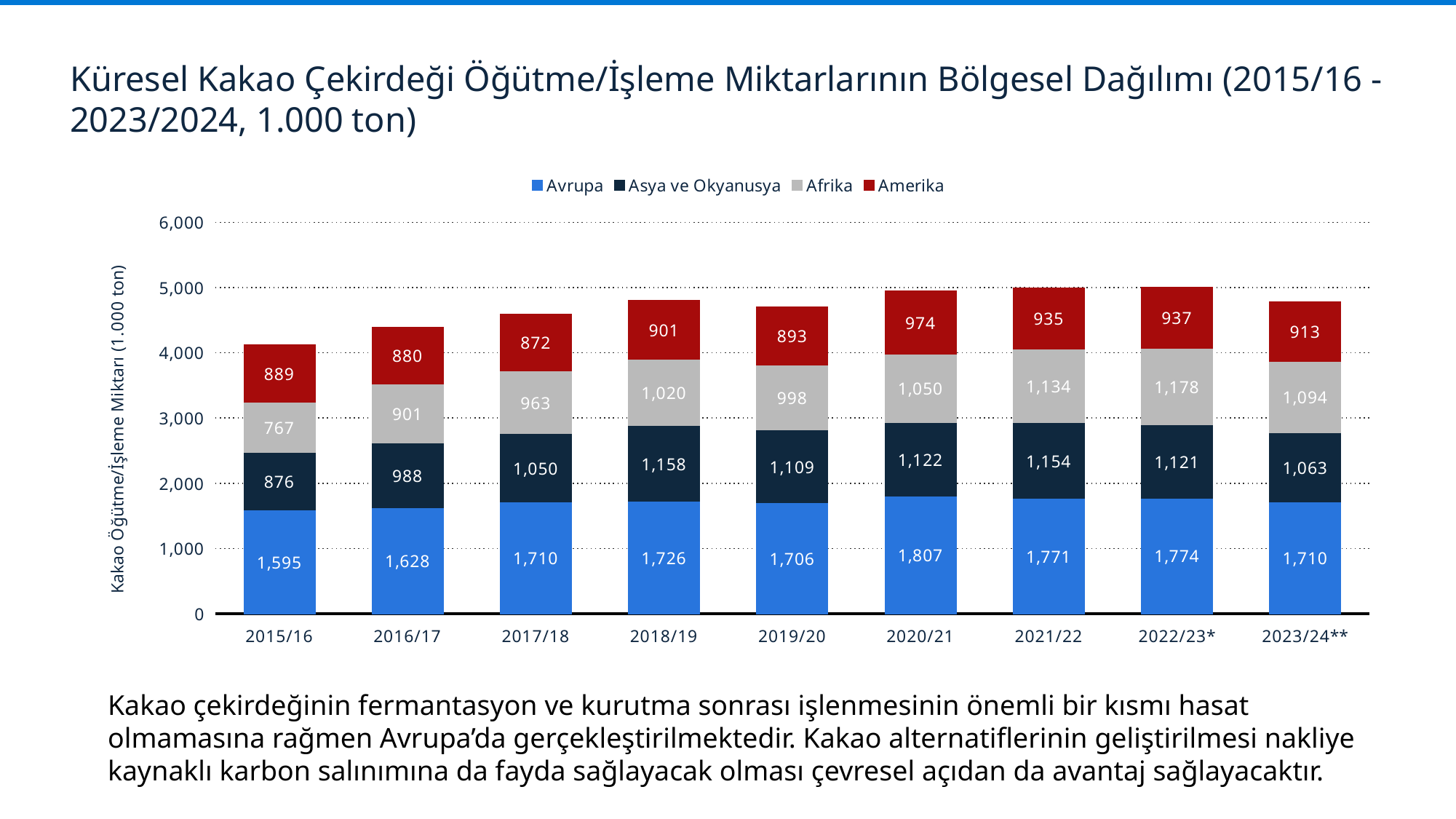
How many series does the legend list? 4 What is the value for Amerika in 2018/19? 901 What is the difference between the Avrupa values for 2020/21 and 2015/16? 212 What is the total of the stacked bar for 2020/21? 4,953 In which season is the Avrupa value highest? 2020/21 What is the value for Afrika in 2022/23*? 1,178 What kind of chart is shown? Stacked bar chart Which is larger in 2018/19, Asya ve Okyanusya or Afrika? Asya ve Okyanusya What is the value for Avrupa in 2015/16? 1,595 How many seasons are shown on the x axis? 9 In which season is the Afrika value lowest? 2015/16 Which series is shown in red in the legend? Amerika